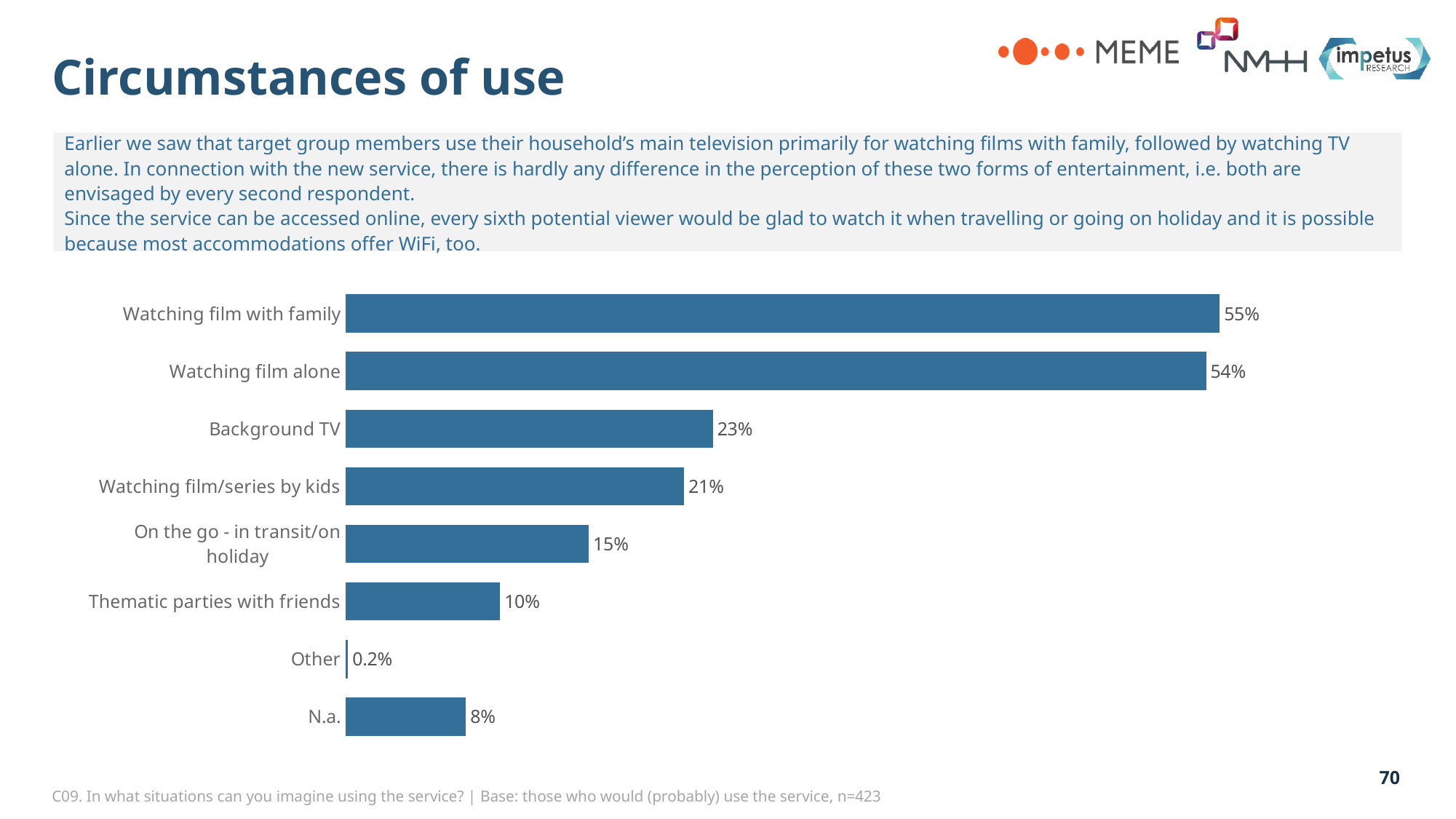
What is the value for Background TV? 23% What is the difference between Watching film with family and Watching film alone? 1% How many categories are shown in the chart? 8 What is the value for On the go - in transit/on holiday? 15% What kind of chart is shown on the slide? Bar chart What is the difference between Background TV and Thematic parties with friends? 13% What is the value for N.a.? 8% Which is larger, Watching film/series by kids or On the go - in transit/on holiday? Watching film/series by kids What is the value for Watching film with family? 55% Which category has the highest value? Watching film with family What is the value for Other? 0.2% Which category has the lowest value? Other